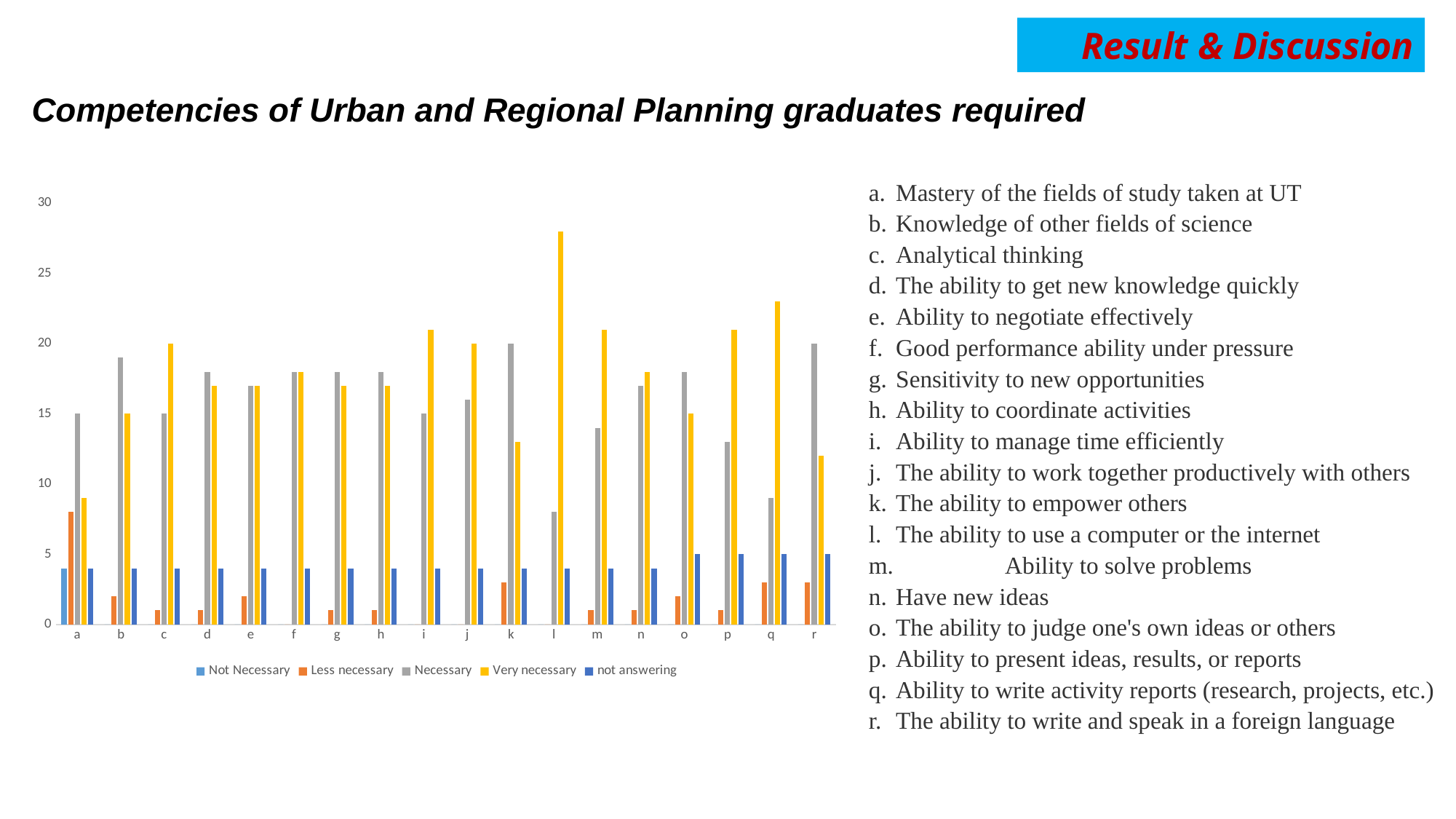
Which is larger for category r, the 'Necessary' bar or the 'Very necessary' bar? Necessary Which category has the lowest 'Necessary' bar? l Is the 'Necessary' value for category b greater or less than 15? greater Is the 'Very necessary' value for category a greater or less than 10? less Is the 'Very necessary' value for category q greater or less than 20? greater Which series is shown in yellow in the chart legend? Very necessary How many series does the chart legend list? 5 How many categories are shown along the x axis of the chart? 18 Which is larger for category p, the 'Necessary' bar or the 'Very necessary' bar? Very necessary What kind of chart is shown on the slide? bar chart Which category has the highest 'Very necessary' bar? l